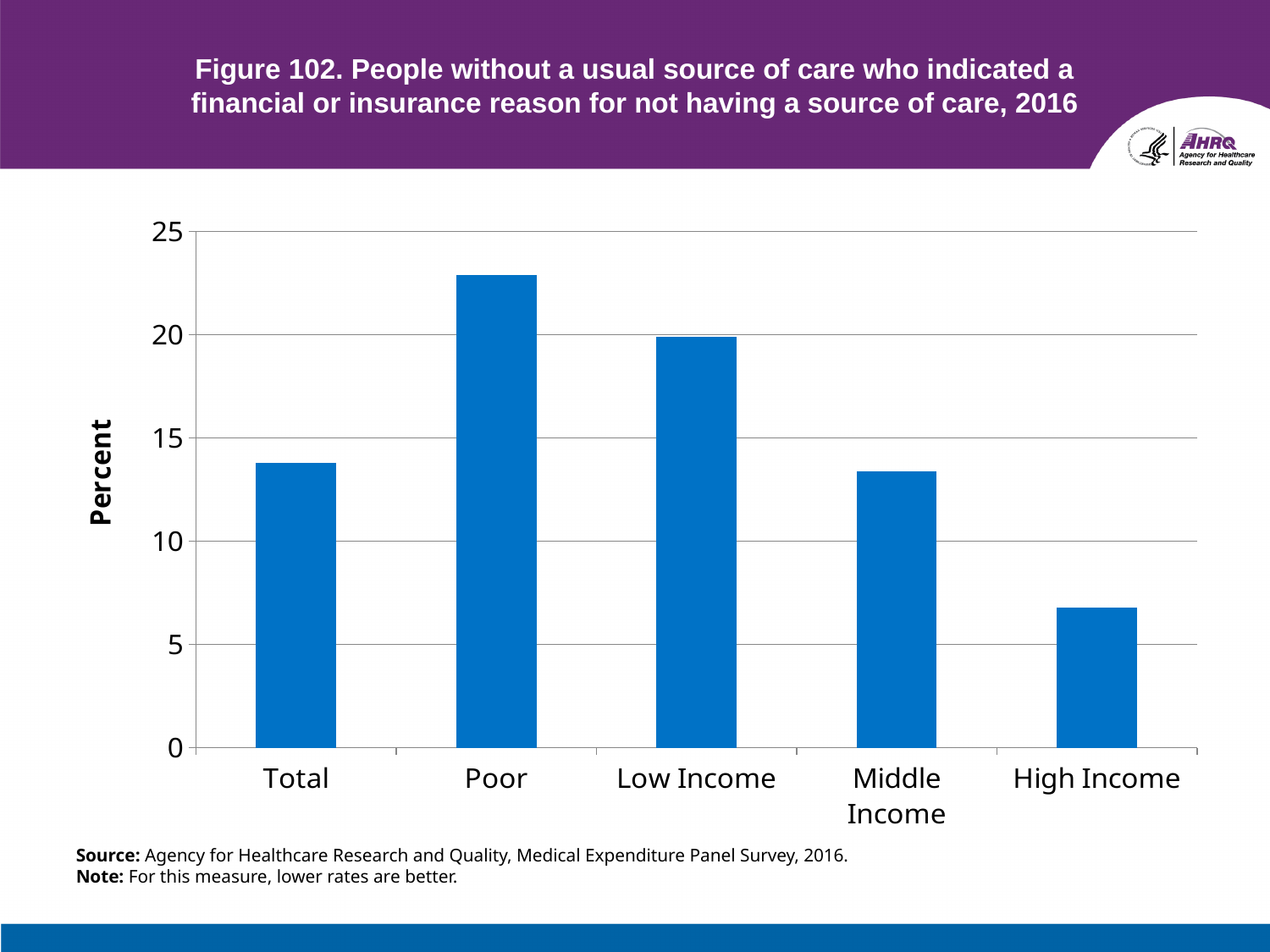
How many categories are shown on the x axis of the chart? 5 What kind of chart is shown on the slide? bar chart Is the value for Low Income greater or less than 15? greater Which category has the lowest value in the chart? High Income Which category has the highest value in the chart? Poor Which is larger, the value for Middle Income or the value for High Income? Middle Income Is the value for Poor greater or less than 20? greater What is the label on the vertical axis of the chart? Percent Is the value for Total greater or less than 10? greater Which is larger, the value for Poor or the value for Low Income? Poor